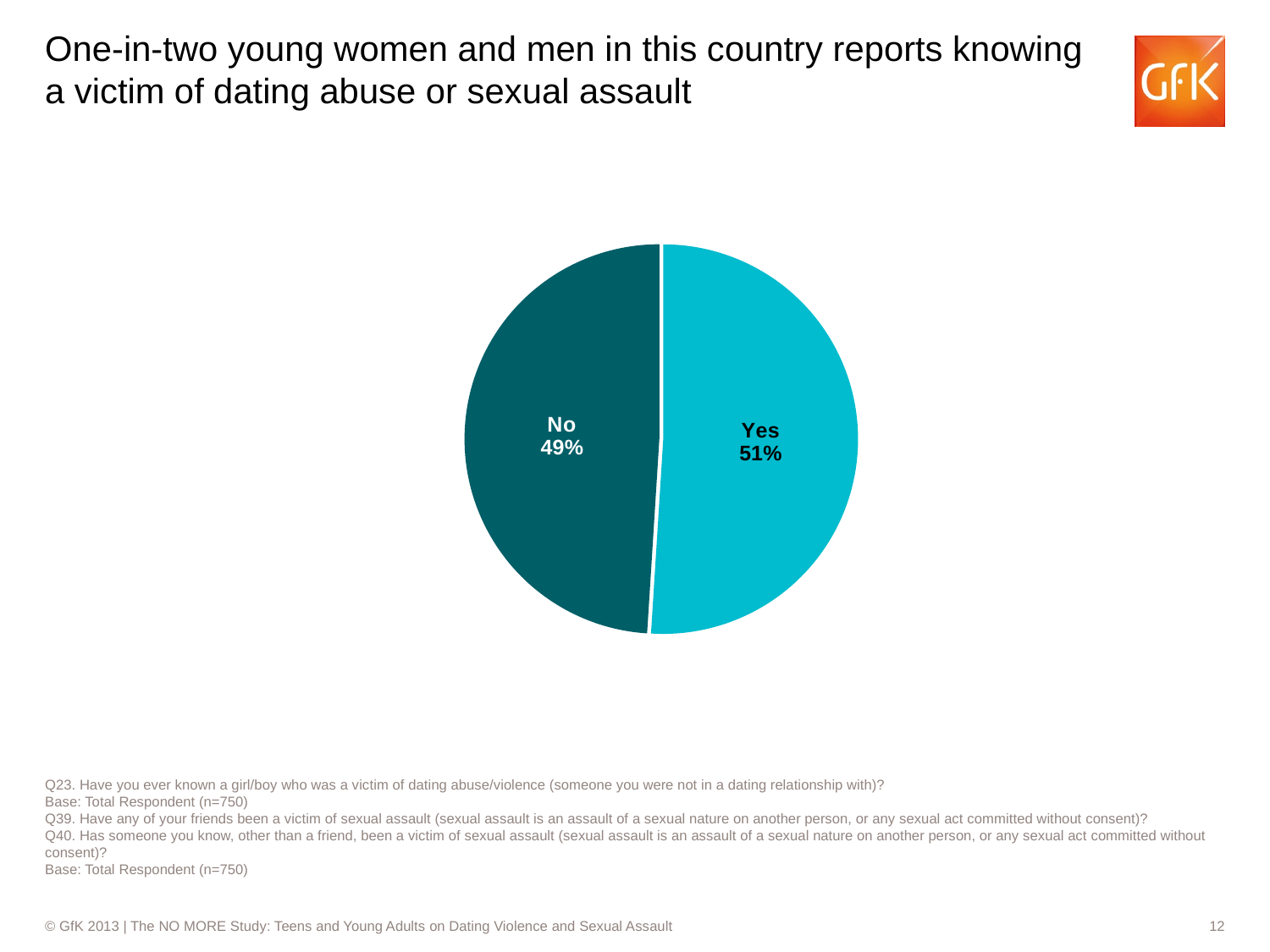
Which slice is shown in the darker teal colour? No What is the base size (n) of respondents noted on the slide? 750 What is the difference in percentage points between the Yes and No slices? 2 How many slices does the pie chart have? 2 Which response has the smallest share of the pie? No What is the total of the Yes and No slices? 100% What kind of chart is shown on the slide? pie chart Which response has the largest share of the pie? Yes What percentage of respondents answered No? 49% What percentage of respondents answered Yes? 51% Which slice is larger, Yes or No? Yes What share of the pie does the No slice represent? 49%